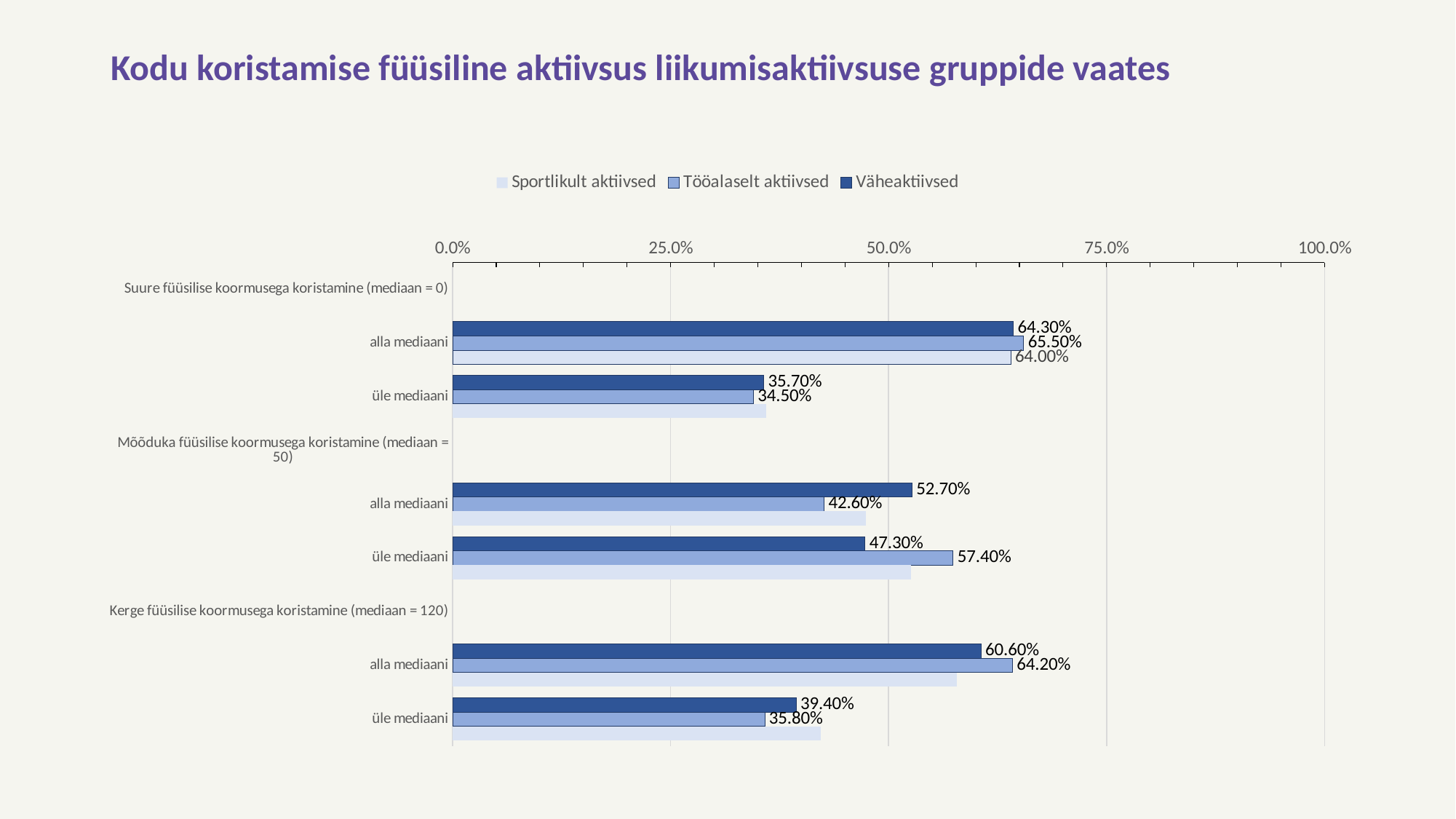
Under 'Mõõduka füüsilise koormusega koristamine (mediaan = 50)', 'üle mediaani', which is larger: Väheaktiivsed or Tööalaselt aktiivsed? Tööalaselt aktiivsed Is the Sportlikult aktiivsed value for 'üle mediaani' under 'Kerge füüsilise koormusega koristamine (mediaan = 120)' greater or less than 50.0%? less What is the value for Väheaktiivsed for 'üle mediaani' under 'Mõõduka füüsilise koormusega koristamine (mediaan = 50)'? 47.30% What is the value for Tööalaselt aktiivsed for 'alla mediaani' under 'Kerge füüsilise koormusega koristamine (mediaan = 120)'? 64.20% What is the value for Sportlikult aktiivsed for 'alla mediaani' under 'Suure füüsilise koormusega koristamine (mediaan = 0)'? 64.00% Is the Sportlikult aktiivsed value for 'alla mediaani' under 'Kerge füüsilise koormusega koristamine (mediaan = 120)' greater or less than 50.0%? greater What kind of chart is shown on the slide? bar chart What is the value for Tööalaselt aktiivsed for 'alla mediaani' under 'Suure füüsilise koormusega koristamine (mediaan = 0)'? 65.50% What is the value for Väheaktiivsed for 'alla mediaani' under 'Suure füüsilise koormusega koristamine (mediaan = 0)'? 64.30% What is the title of the chart? Kodu koristamise füüsiline aktiivsus liikumisaktiivsuse gruppide vaates What is the difference between the Väheaktiivsed and Tööalaselt aktiivsed values for 'alla mediaani' under 'Mõõduka füüsilise koormusega koristamine (mediaan = 50)'? 10.10% How many series does the legend list? 3